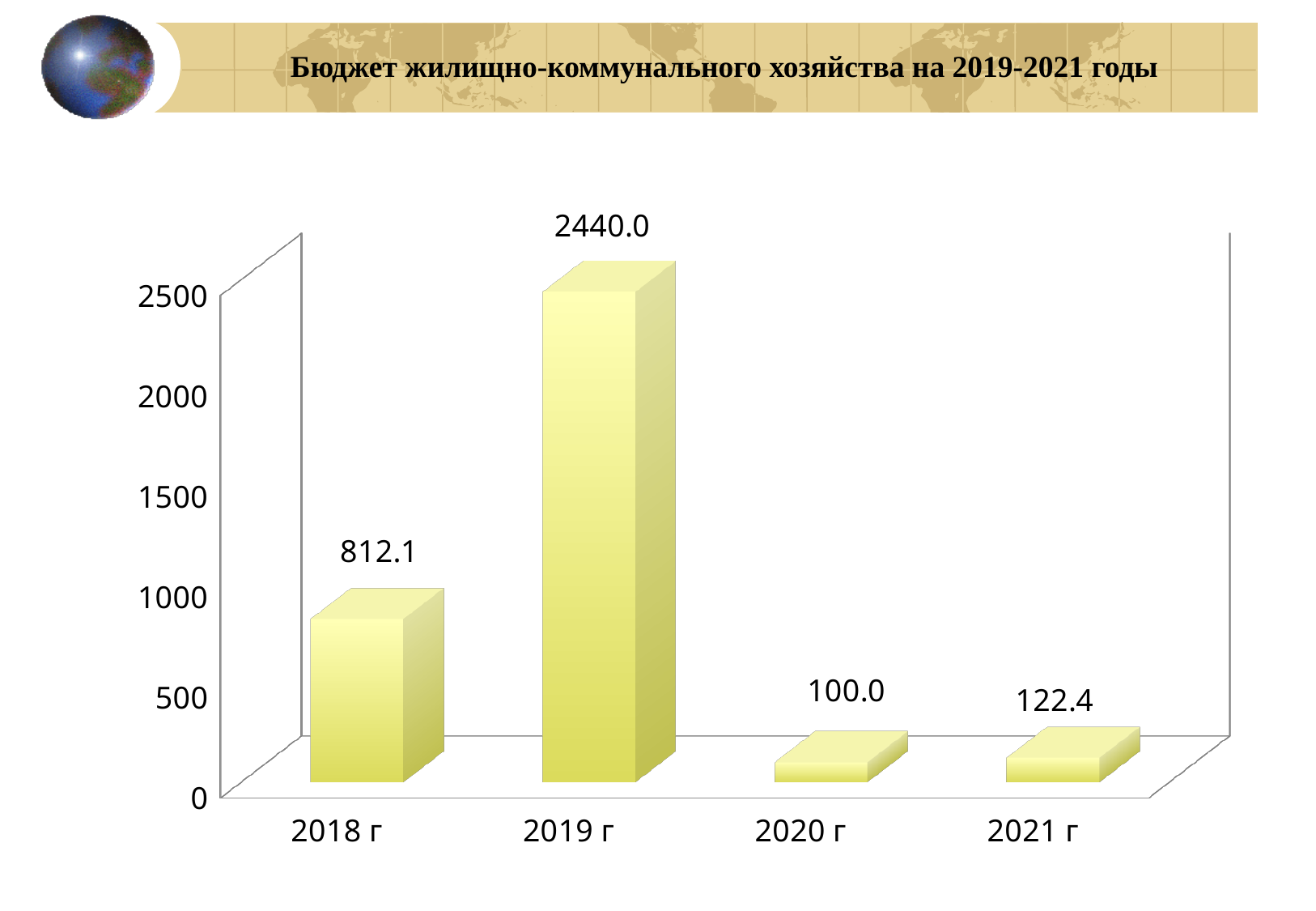
What is the difference between the values for 2021 г and 2020 г? 22.4 Is the value for 2018 г greater or less than 1000? less How many years are shown on the x axis? 4 What is the value for 2020 г? 100.0 Which year has the lowest value? 2020 г Which year has the highest value? 2019 г What is the value for 2019 г? 2440.0 What is the value for 2021 г? 122.4 What is the value for 2018 г? 812.1 What is the difference between the values for 2019 г and 2018 г? 1627.9 What kind of chart is shown on the slide? bar chart Which is larger, the value for 2018 г or the value for 2021 г? 2018 г